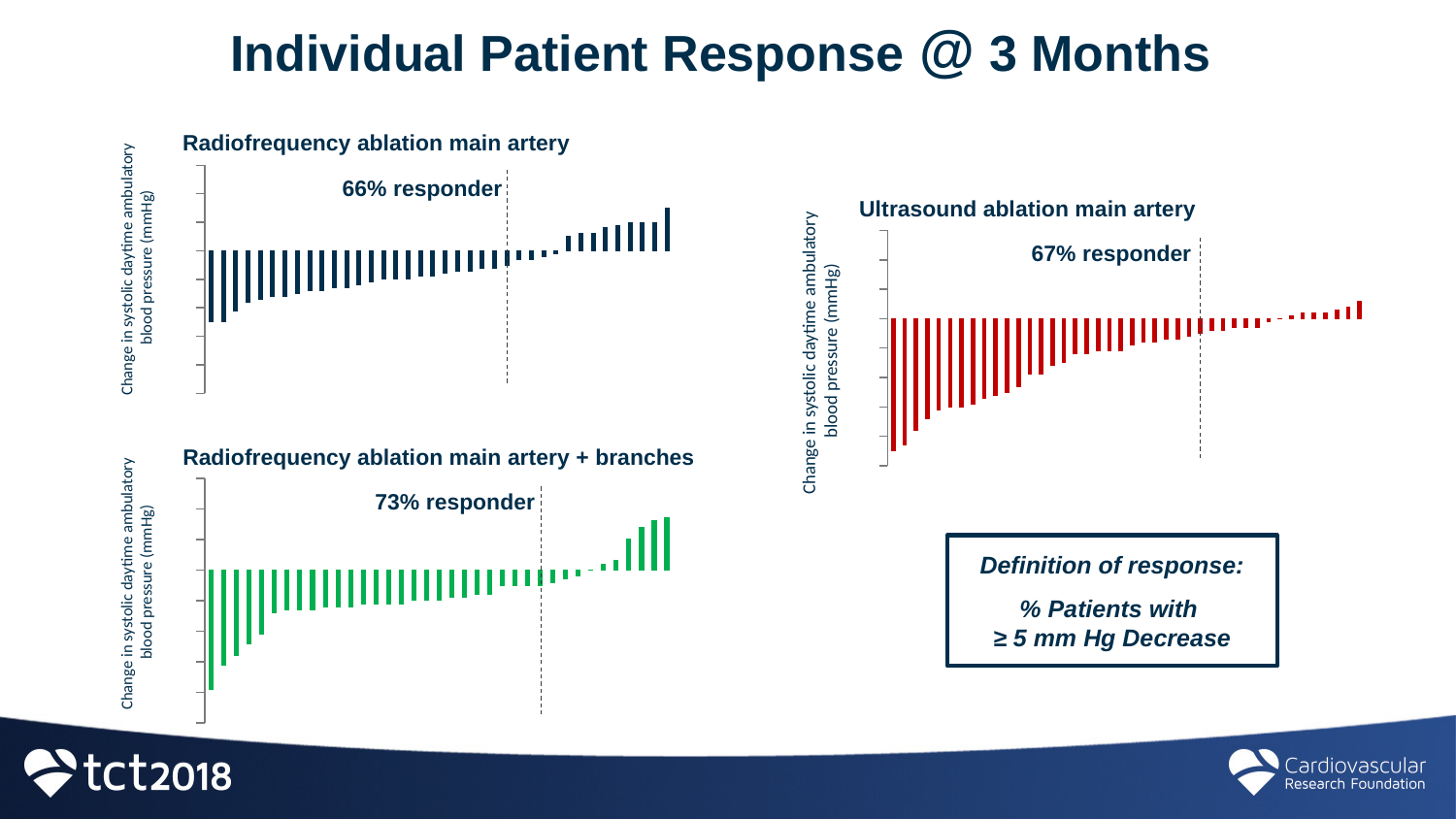
How many charts are shown on the slide? 3 In the 'Radiofrequency ablation main artery + branches' chart, what responder percentage is shown? 73% responder What kind of chart is the 'Radiofrequency ablation main artery' chart? Bar chart In the 'Ultrasound ablation main artery' chart, what responder percentage is shown? 67% responder Which of the three charts shows the highest responder percentage? Radiofrequency ablation main artery + branches In the 'Ultrasound ablation main artery' chart, do the bar values rise or fall from left to right? Rise Which has the larger responder percentage: the 'Ultrasound ablation main artery' chart or the 'Radiofrequency ablation main artery' chart? Ultrasound ablation main artery What is the y-axis label of the 'Radiofrequency ablation main artery + branches' chart? Change in systolic daytime ambulatory blood pressure (mmHg) In the 'Radiofrequency ablation main artery' chart, what responder percentage is shown? 66% responder What is the difference between the responder percentage in the 'Radiofrequency ablation main artery + branches' chart and the 'Radiofrequency ablation main artery' chart? 7 percentage points Which of the three charts shows the lowest responder percentage? Radiofrequency ablation main artery In the 'Radiofrequency ablation main artery' chart, do the bar values rise or fall from left to right? Rise